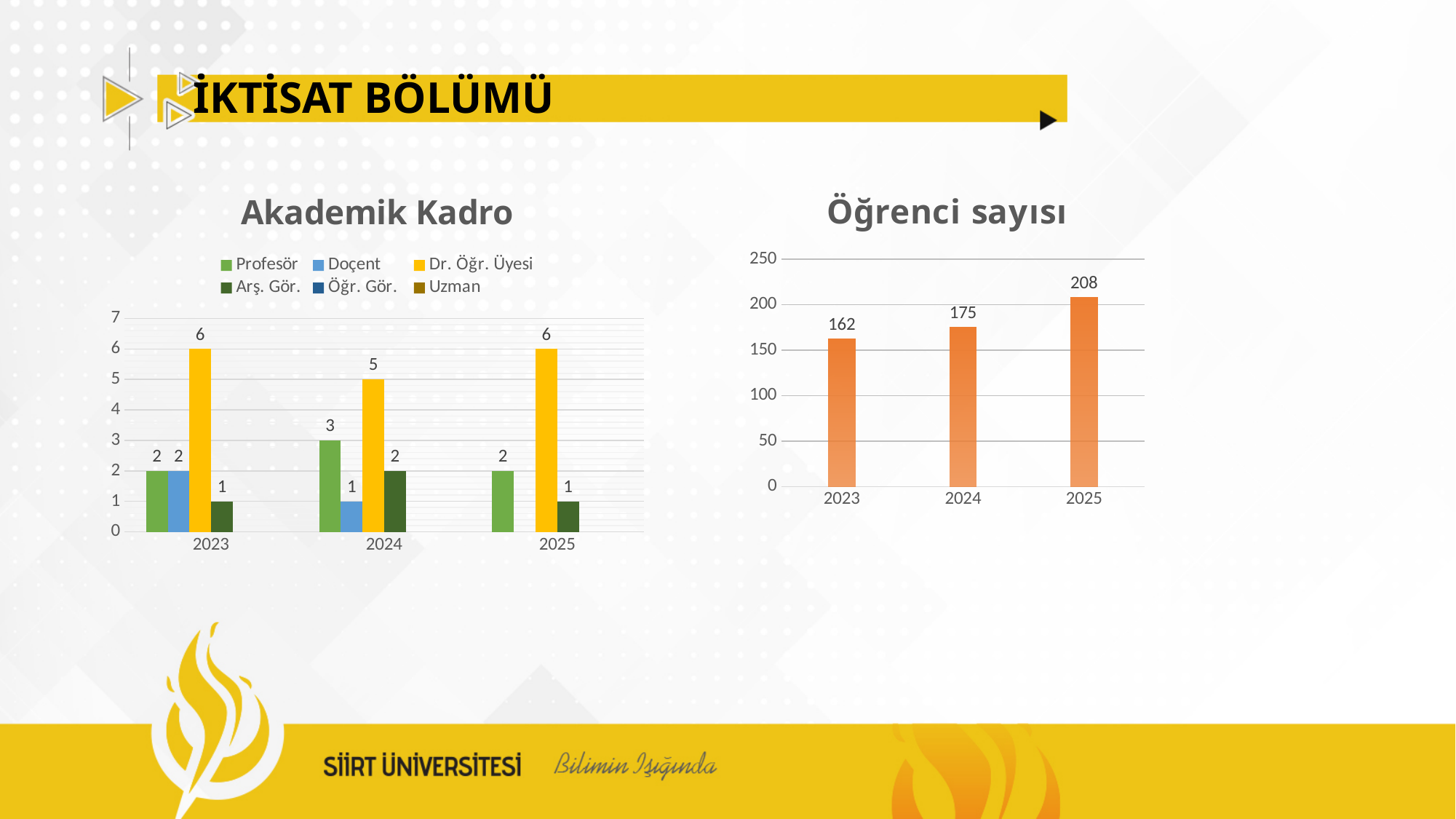
In the 'Akademik Kadro' chart, what is the value for Dr. Öğr. Üyesi in 2024? 5 In the 'Akademik Kadro' chart, how many series does the legend list? 6 In the 'Öğrenci sayısı' chart, what is the difference between the values for 2025 and 2023? 46 What kind of chart is the 'Öğrenci sayısı' chart? bar chart In the 'Öğrenci sayısı' chart, how many years are shown on the x axis? 3 In the 'Öğrenci sayısı' chart, do the values rise or fall from 2023 to 2025? rise In the 'Akademik Kadro' chart, what is the value for Profesör in 2024? 3 In the 'Akademik Kadro' chart, is the value for Arş. Gör. in 2024 larger or smaller than the value for Arş. Gör. in 2023? larger In the 'Akademik Kadro' chart, which series has the highest value in 2023? Dr. Öğr. Üyesi In the 'Öğrenci sayısı' chart, which year has the lowest value? 2023 In the 'Akademik Kadro' chart, what is the difference between the Dr. Öğr. Üyesi values for 2023 and 2024? 1 In the 'Öğrenci sayısı' chart, what is the value for 2025? 208